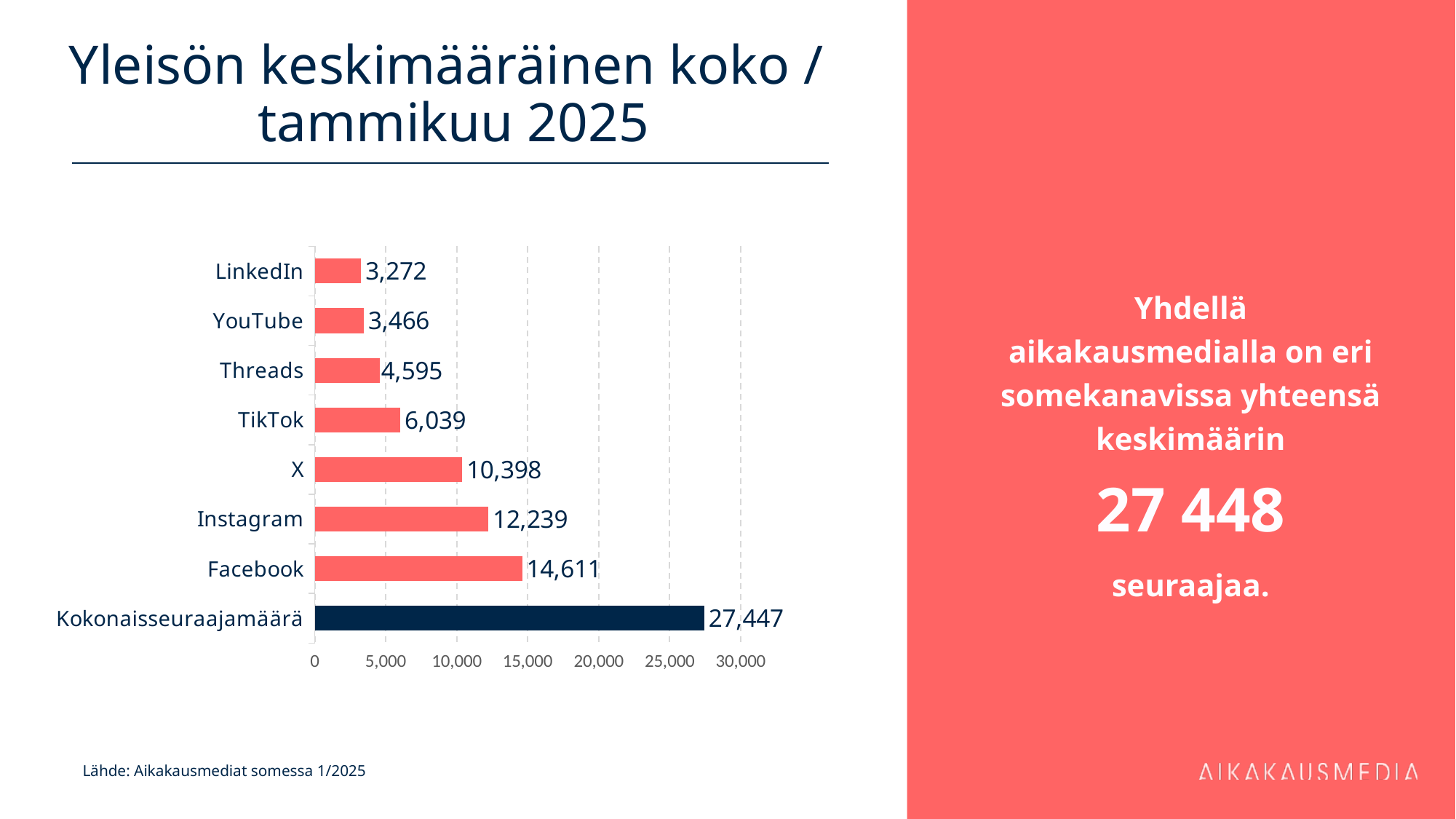
What colour is the bar for Kokonaisseuraajamäärä? dark navy blue Which category has the highest value? Kokonaisseuraajamäärä What is the difference between the values for YouTube and LinkedIn? 194 Which is larger, the value for X or the value for TikTok? X Is the value for Instagram greater or less than 10,000? greater What is the value for TikTok? 6,039 How many categories are shown in the chart? 8 What is the difference between the values for Facebook and Instagram? 2,372 What kind of chart is shown on the slide? bar chart What is the value for Facebook? 14,611 What is the value for Kokonaisseuraajamäärä? 27,447 Which category has the lowest value? LinkedIn